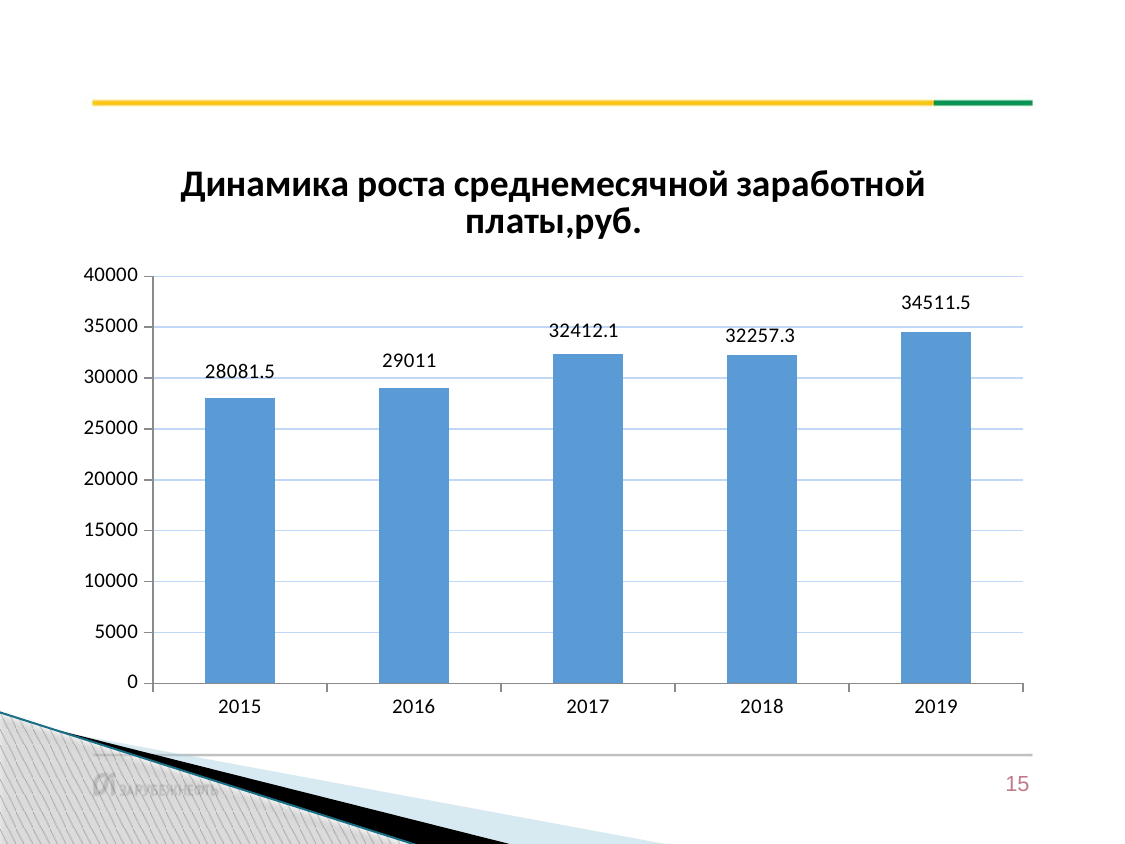
What is the difference between the values for 2016 and 2015? 929.5 What value is labelled on the bar for 2015? 28081.5 Which year has the lowest value on the chart? 2015 Is the value for 2018 greater or less than 30000? greater What is the average monthly salary value shown for 2017? 32412.1 Which year has the highest value on the chart? 2019 Which is larger, the value for 2016 or the value for 2017? 2017 What kind of chart is shown on the slide? bar chart What is the title of the chart? Динамика роста среднемесячной заработной платы,руб. What is the difference between the values for 2019 and 2015? 6430 How many years are shown on the x axis? 5 What is the value shown for 2019? 34511.5